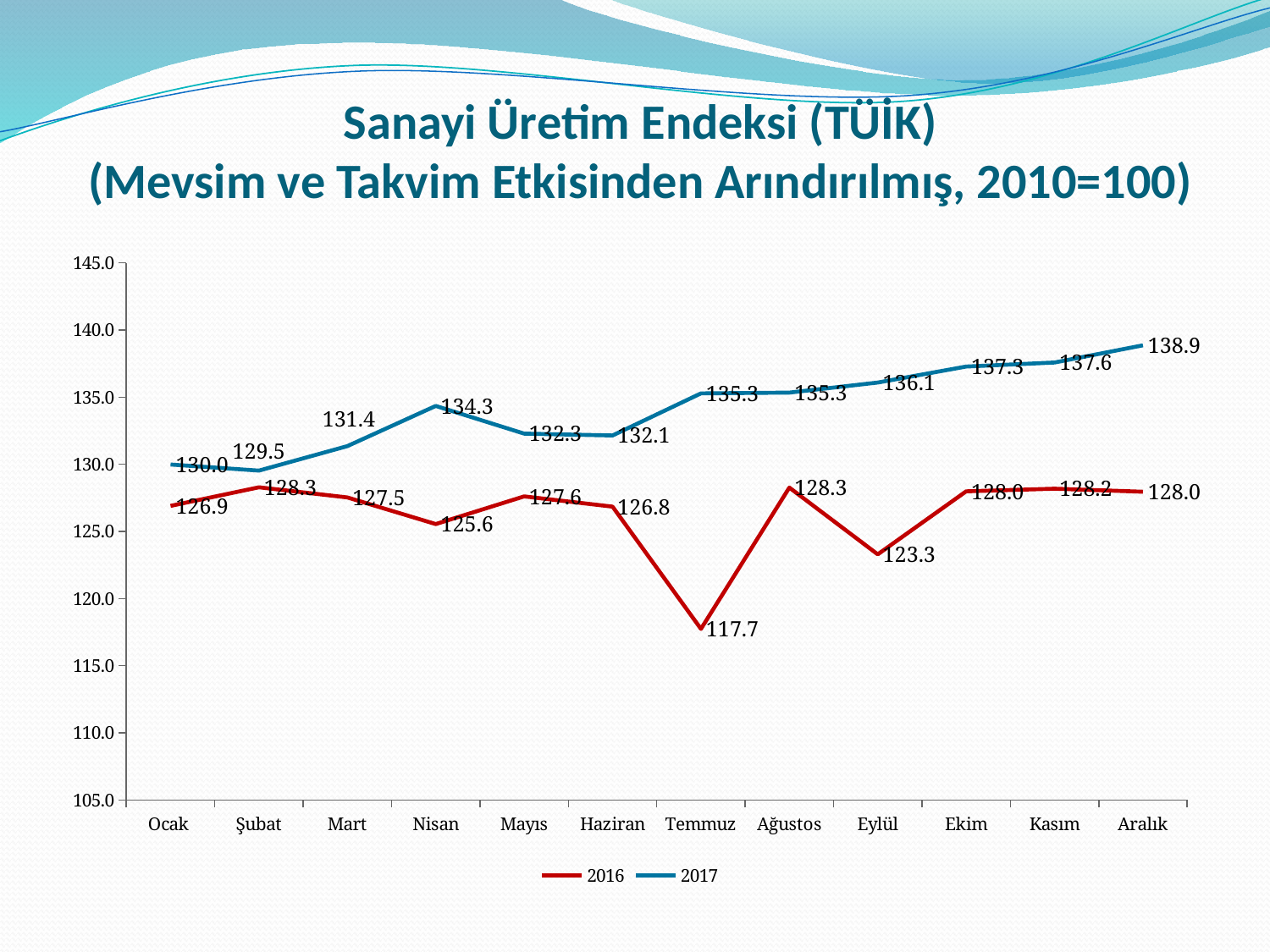
What is the value for 2016 in Temmuz? 117.7 In which month is the 2017 value highest? Aralık Which is larger, the 2016 value in Eylül or the 2016 value in Ekim? Ekim What is the value for 2017 in Nisan? 134.3 Does the 2017 series generally rise or fall from Ocak to Aralık? Rise How many months are plotted along the x axis? 12 What is the value for 2017 in Aralık? 138.9 In which month is the 2016 value lowest? Temmuz Which colour is used for the 2017 series? Blue How many series does the legend list? 2 What type of chart is shown on the slide? Line chart What is the difference between the 2017 and 2016 values in Temmuz? 17.6